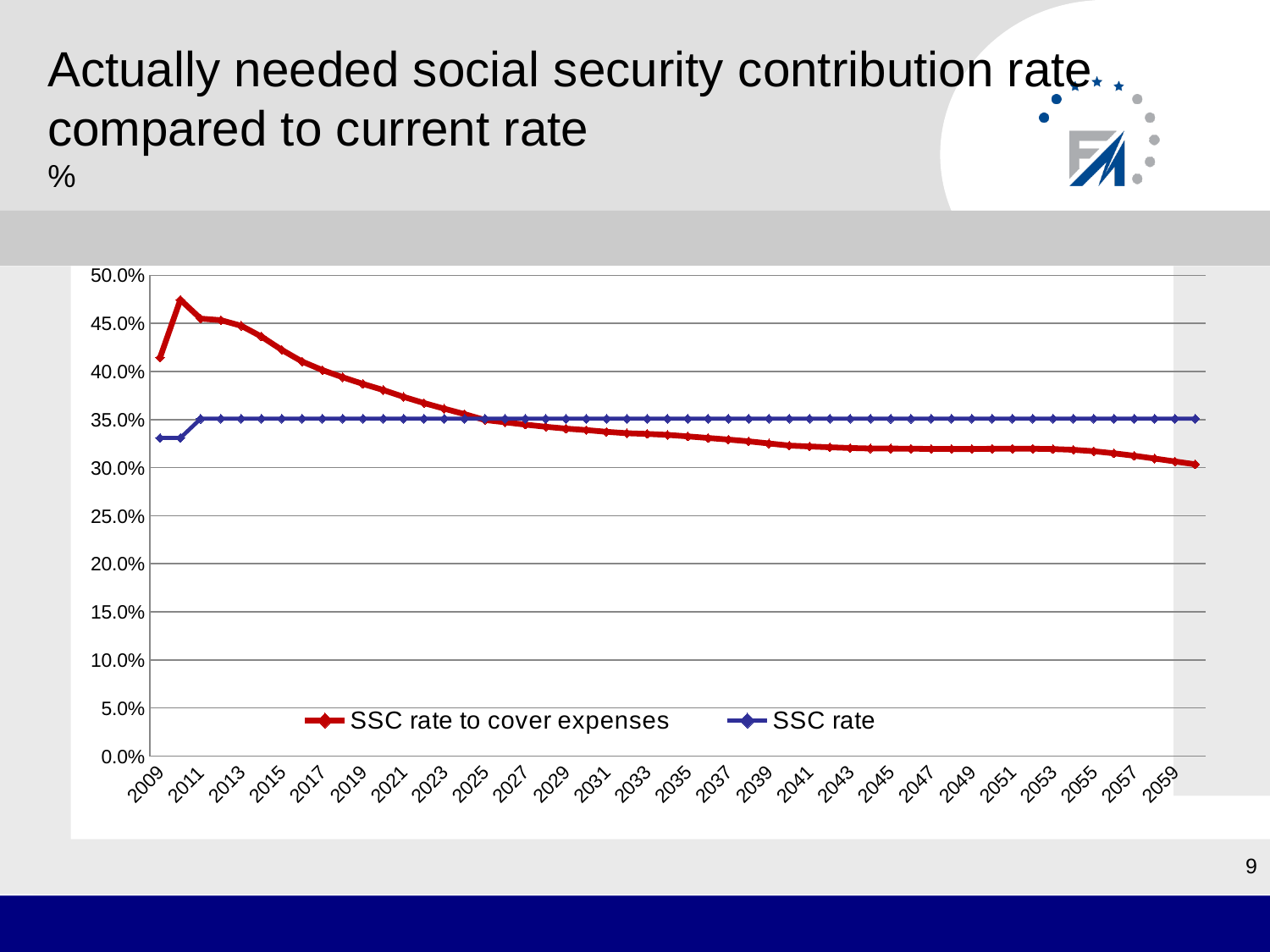
Which colour is used for the 'SSC rate to cover expenses' series? red What is the last year labelled on the x axis? 2059 Does the 'SSC rate to cover expenses' series rise or fall between 2011 and 2059? fall Is the value of 'SSC rate' in 2009 greater or less than 35.0%? less Is the value of 'SSC rate to cover expenses' in 2015 greater or less than 40.0%? greater In 2015, which series has the higher value, 'SSC rate to cover expenses' or 'SSC rate'? SSC rate to cover expenses In 2045, which series has the higher value, 'SSC rate to cover expenses' or 'SSC rate'? SSC rate What are the two series named in the legend? SSC rate to cover expenses; SSC rate Is the value of 'SSC rate to cover expenses' in 2059 greater or less than 35.0%? less What type of chart is shown on the slide? line chart How many series does the legend list? 2